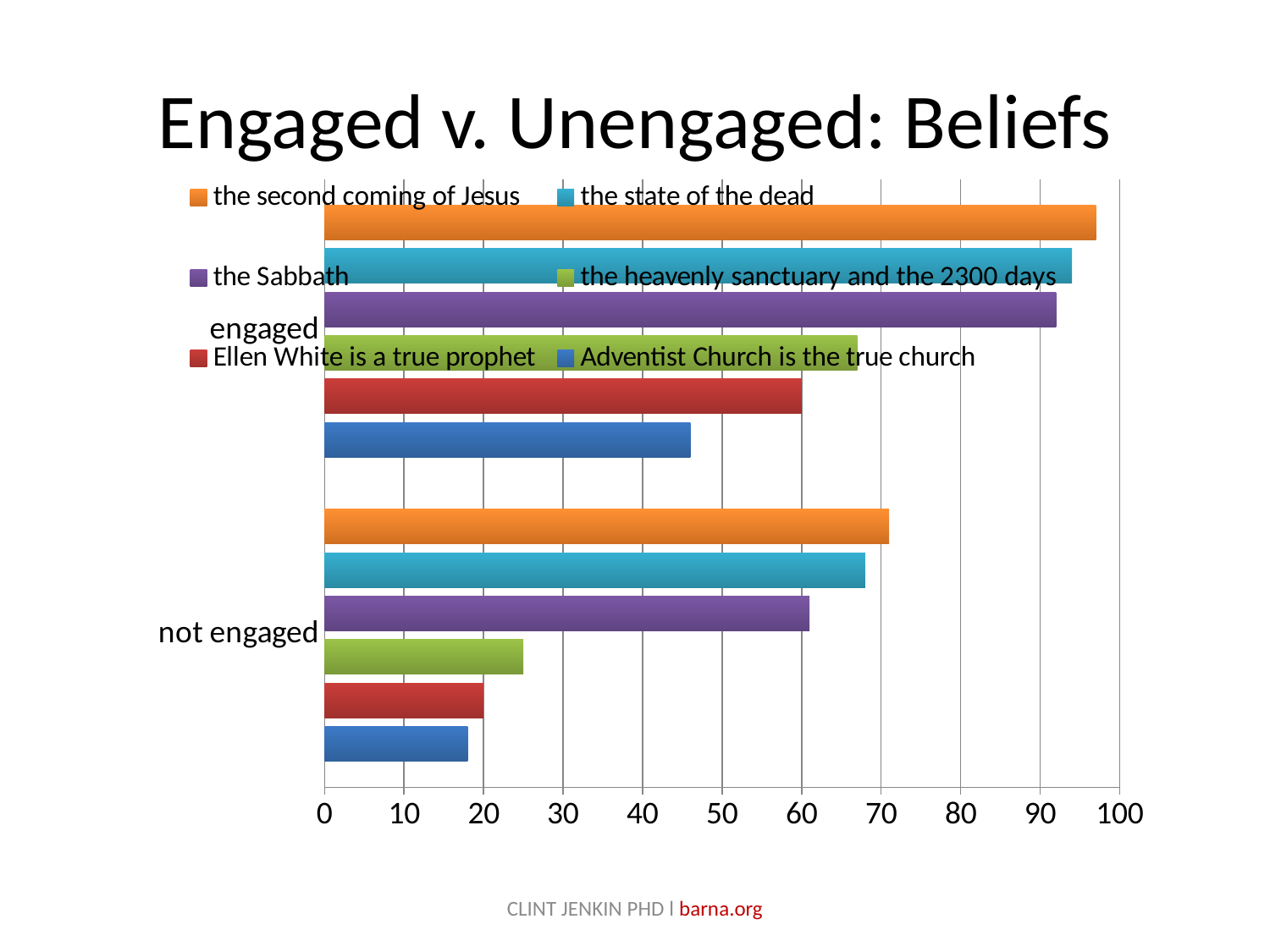
Which group has the larger value for "the Sabbath", engaged or not engaged? engaged How many series does the legend list? 6 What kind of chart is shown on the slide? bar chart For the engaged group, which belief has the highest value? the second coming of Jesus Is the value for "the second coming of Jesus" in the engaged group greater or less than 90? greater For the engaged group, which belief has the lowest value? Adventist Church is the true church Is the value for "Ellen White is a true prophet" in the not engaged group greater or less than 30? less What is the title of the chart? Engaged v. Unengaged: Beliefs How many categories are shown on the vertical axis? 2 Is the value for "Adventist Church is the true church" in the engaged group greater or less than 50? less Which colour represents the series "the Sabbath"? purple